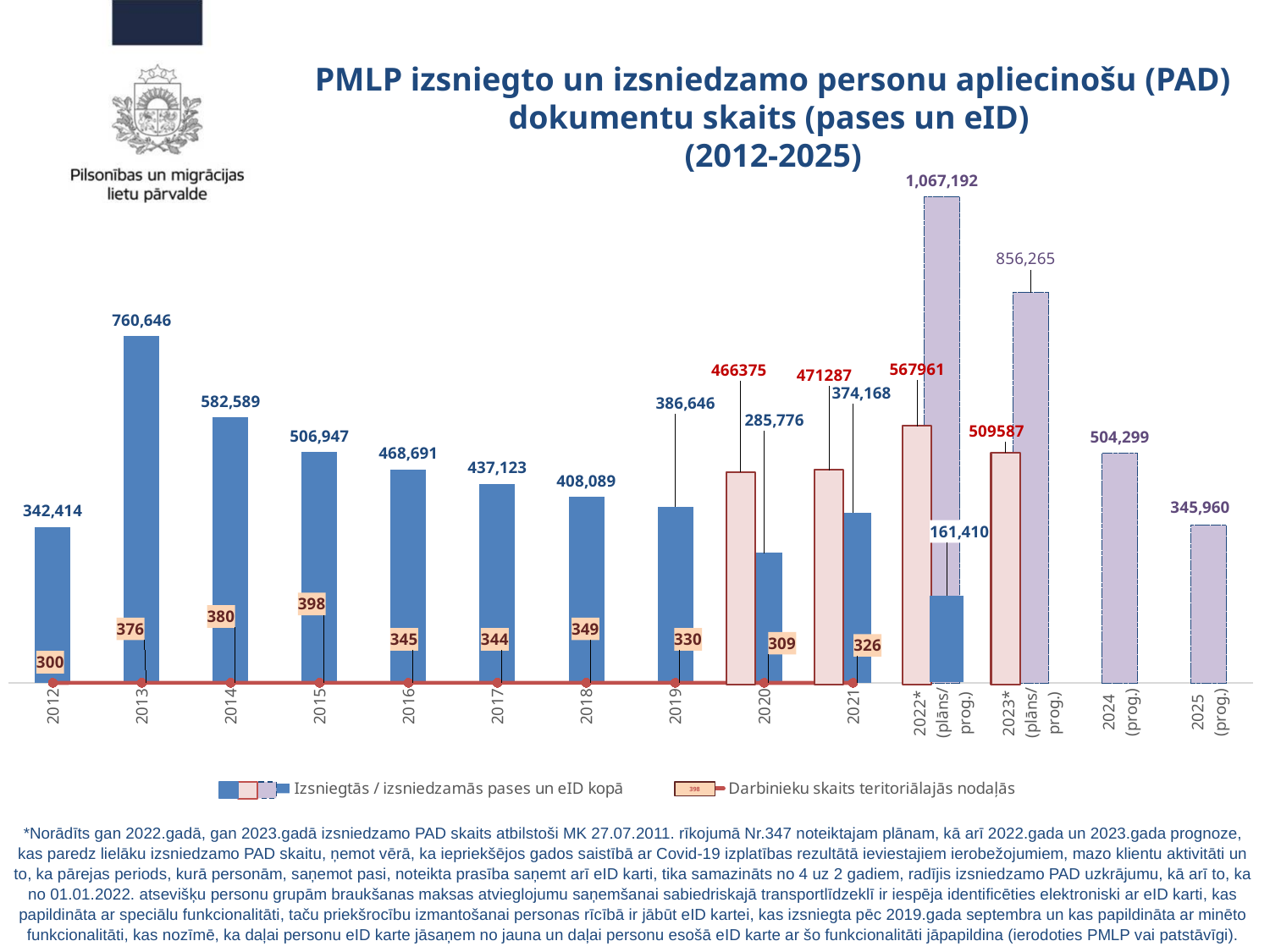
Do the issued document values rise or fall from 2013 to 2019? fall What is the difference between the number of issued documents in 2013 and in 2012? 418,232 Among the years 2012 to 2021, which year has the highest number of issued passports and eID documents? 2013 Which year has a larger number of issued documents, 2014 or 2015? 2014 In which year is the number of employees in territorial departments the lowest? 2012 How many years are shown on the x axis? 14 What is the number of employees in territorial departments (Darbinieku skaits teritoriālajās nodaļās) in 2018? 349 How many series does the legend list? 2 In which year is the number of employees in territorial departments the highest? 2015 What is the forecast (prog.) number of documents for 2025? 345,960 What is the number of issued passports and eID documents in 2012? 342,414 What is the number of issued passports and eID documents in 2013? 760,646